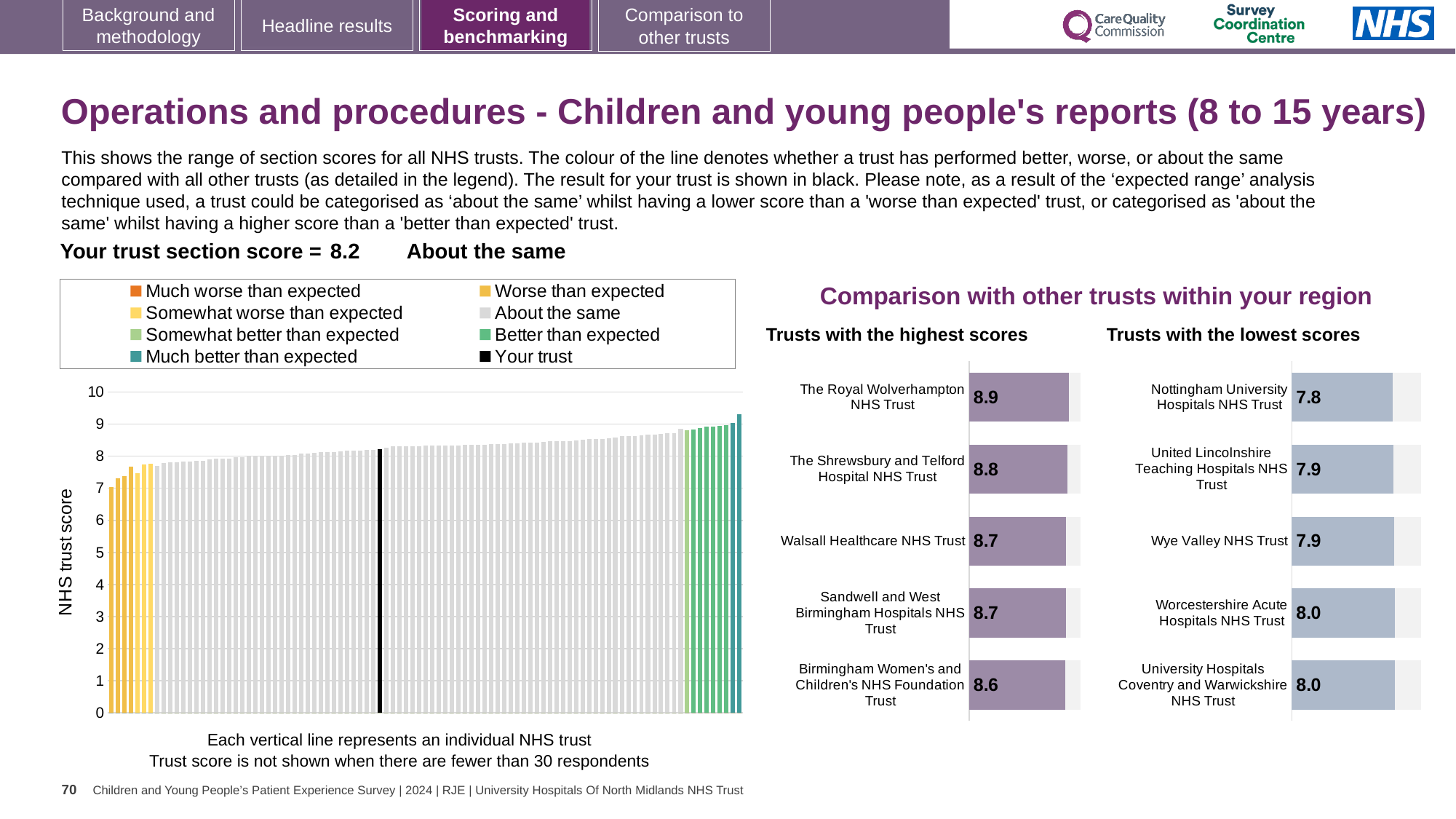
In the 'Trusts with the lowest scores' chart, which trust has the lowest score? Nottingham University Hospitals NHS Trust In the main chart of NHS trust scores, do the values rise or fall from left to right? rise In the 'Trusts with the highest scores' chart, what is the difference between the scores of The Royal Wolverhampton NHS Trust and Birmingham Women's and Children's NHS Foundation Trust? 0.3 In the 'Trusts with the highest scores' chart, how many trusts are shown? 5 What kind of chart is the main chart showing the range of section scores for all NHS trusts? bar chart In the 'Trusts with the highest scores' chart, which trust has the highest score? The Royal Wolverhampton NHS Trust In the 'Trusts with the highest scores' chart, what is the score for The Royal Wolverhampton NHS Trust? 8.9 In the 'Trusts with the lowest scores' chart, what is the score for Wye Valley NHS Trust? 7.9 In the main chart of NHS trust scores, what is the section score for your trust? 8.2 In the main chart of NHS trust scores, is the value of the leftmost bar greater or less than 8? less In the main chart of NHS trust scores, what is the label on the vertical axis? NHS trust score How many entries does the legend above the main chart of NHS trust scores list? 8